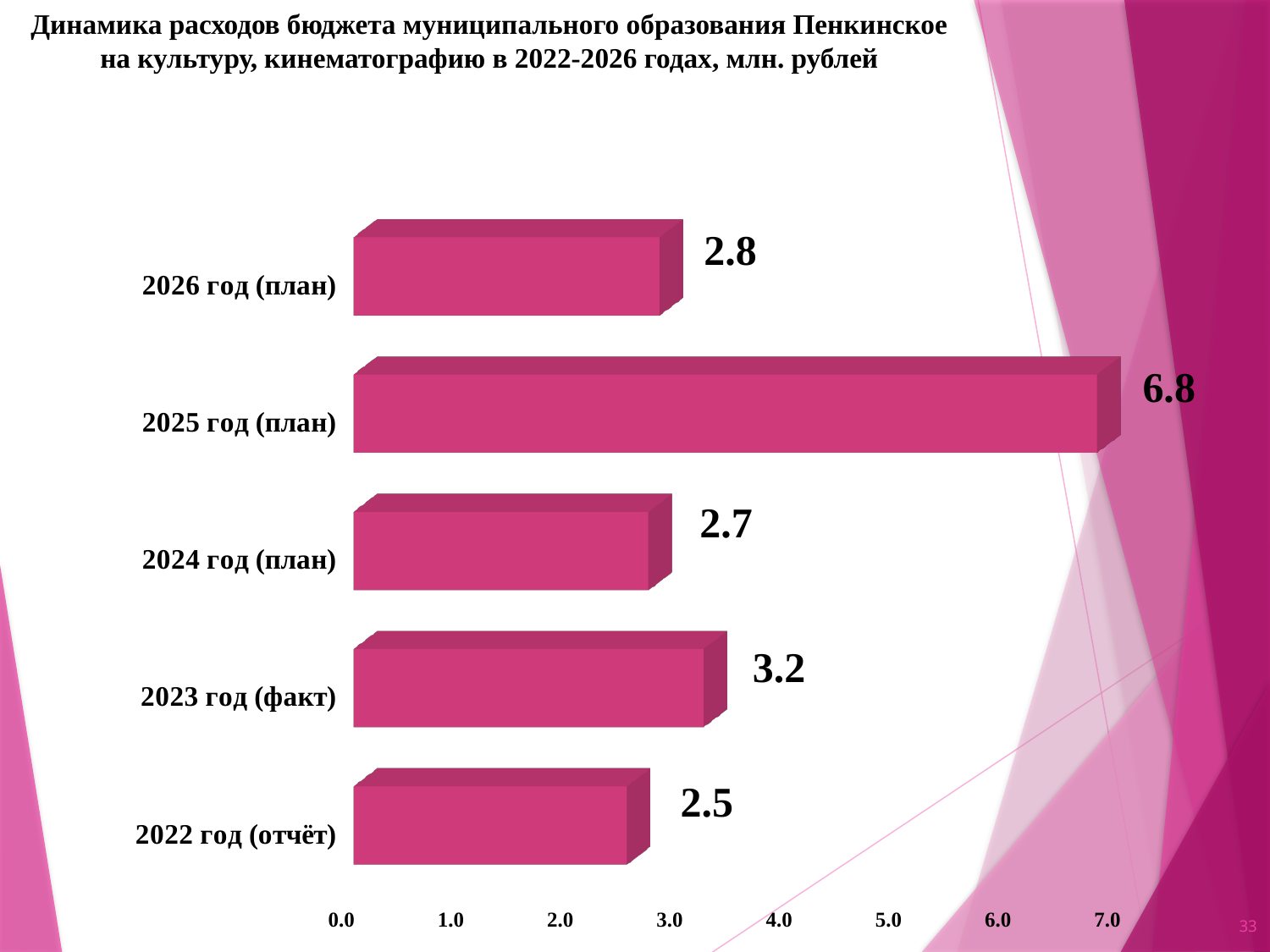
Which category has the highest value? 2025 год (план) Which is larger, the value for 2023 год (факт) or the value for 2026 год (план)? 2023 год (факт) What is the value for 2025 год (план)? 6.8 What is the value for 2022 год (отчёт)? 2.5 Which category has the lowest value? 2022 год (отчёт) How many categories are shown in the chart? 5 What is the value for 2026 год (план)? 2.8 What is the value for 2023 год (факт)? 3.2 What is the difference between the values for 2025 год (план) and 2024 год (план)? 4.1 What is the difference between the values for 2023 год (факт) and 2022 год (отчёт)? 0.7 In what units are the values in the chart expressed, according to the title? млн. рублей What kind of chart is shown on the slide? bar chart